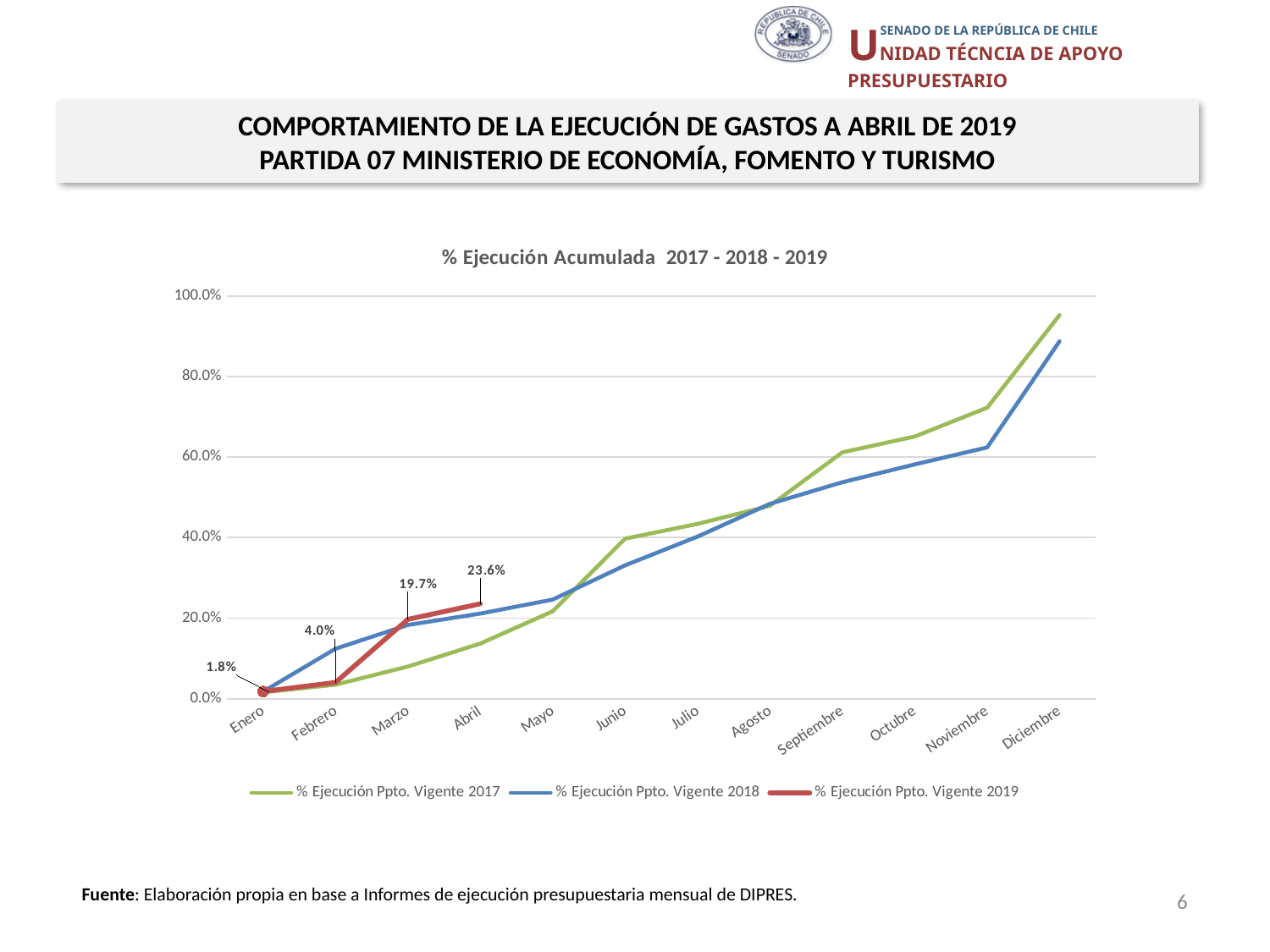
How many series does the legend list? 3 Which month has the highest value for the % Ejecución Ppto. Vigente 2019 series? Abril How many months are shown on the x axis? 12 What is the value of % Ejecución Ppto. Vigente 2019 for Marzo? 19.7% What is the difference between the 2019 values for Abril and Marzo? 3.9 percentage points Which series has the higher value in Diciembre, 2017 or 2018? % Ejecución Ppto. Vigente 2017 What kind of chart is shown on the slide? Line chart What is the title of the chart? % Ejecución Acumulada 2017 - 2018 - 2019 Is the value for % Ejecución Ppto. Vigente 2017 in Diciembre greater or less than 80.0%? greater Which month has the lowest value for the % Ejecución Ppto. Vigente 2019 series? Enero What is the value of % Ejecución Ppto. Vigente 2019 for Abril? 23.6% What is the value of % Ejecución Ppto. Vigente 2019 for Enero? 1.8%